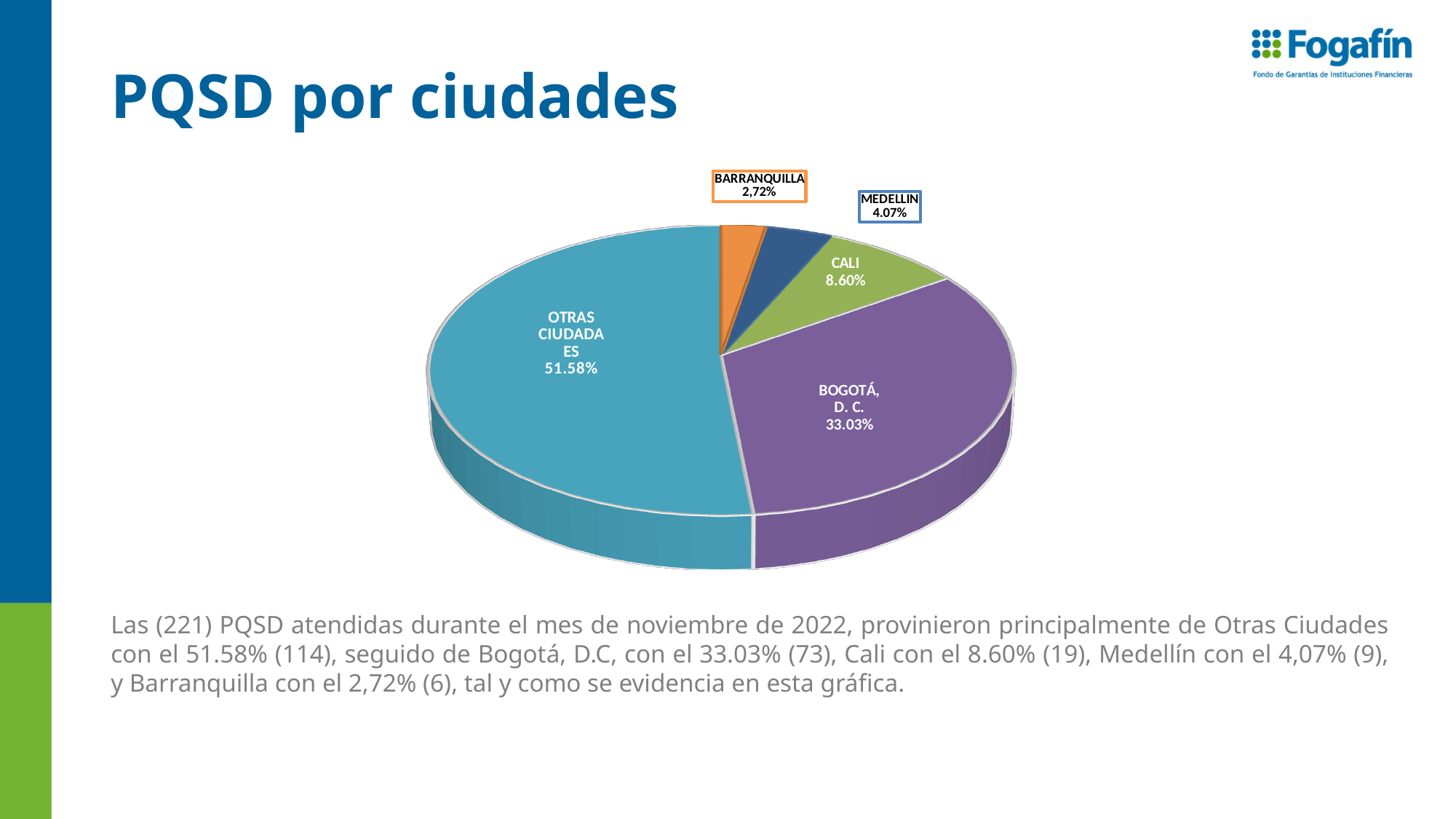
What is the value shown for CALI? 8.60% What is the value shown for BOGOTÁ, D. C.? 33.03% How many slices does the pie chart have? 5 Which is larger, the slice for CALI or the slice for MEDELLIN? CALI What is the value shown for BARRANQUILLA? 2,72% What kind of chart is shown on the slide? Pie chart What share of the pie does OTRAS CIUDADES represent? 51.58% What is the value shown for MEDELLIN? 4.07% Which city has the largest slice of the pie? OTRAS CIUDADES Which city has the smallest slice of the pie? BARRANQUILLA What is the difference in percentage points between OTRAS CIUDADES and BOGOTÁ, D. C.? 18.55 What is the title of the slide containing the chart? PQSD por ciudades